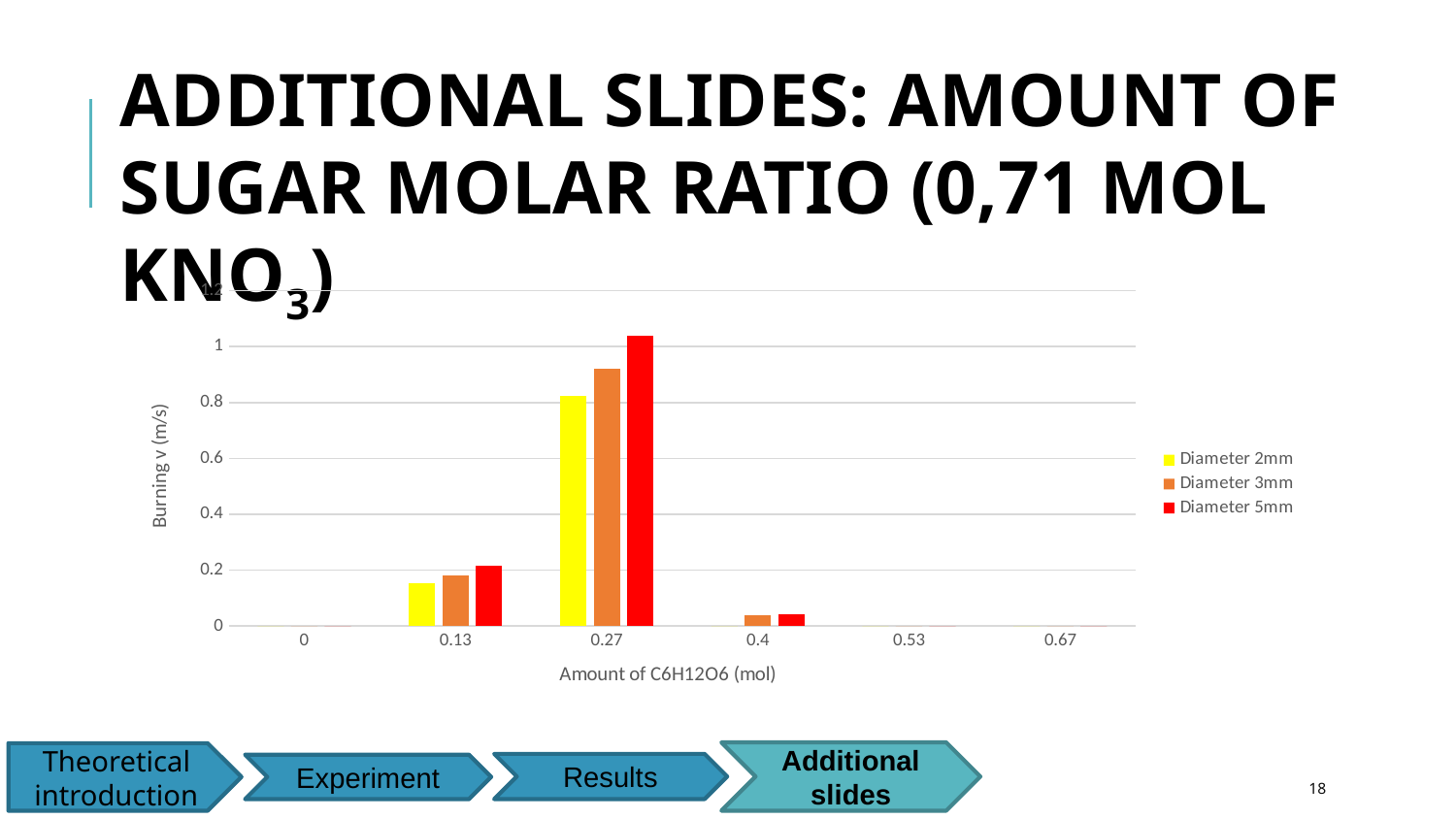
At which amount of C6H12O6 is the burning velocity highest for all three diameters? 0.27 Is the value for Diameter 5mm at 0.27 mol greater or less than 1? greater Is the value for Diameter 3mm at 0.13 mol greater or less than 0.2? less Which colour represents Diameter 2mm in the legend? yellow What is the label of the y axis? Burning v (m/s) Is the value for Diameter 3mm at 0.27 mol greater or less than 1? less How many categories are shown on the x axis? 6 What kind of chart is shown on the slide? bar chart How many series does the legend list? 3 At 0.27 mol, which is larger: the value for Diameter 2mm or Diameter 5mm? Diameter 5mm At 0.13 mol, which is larger: the value for Diameter 2mm or Diameter 3mm? Diameter 3mm